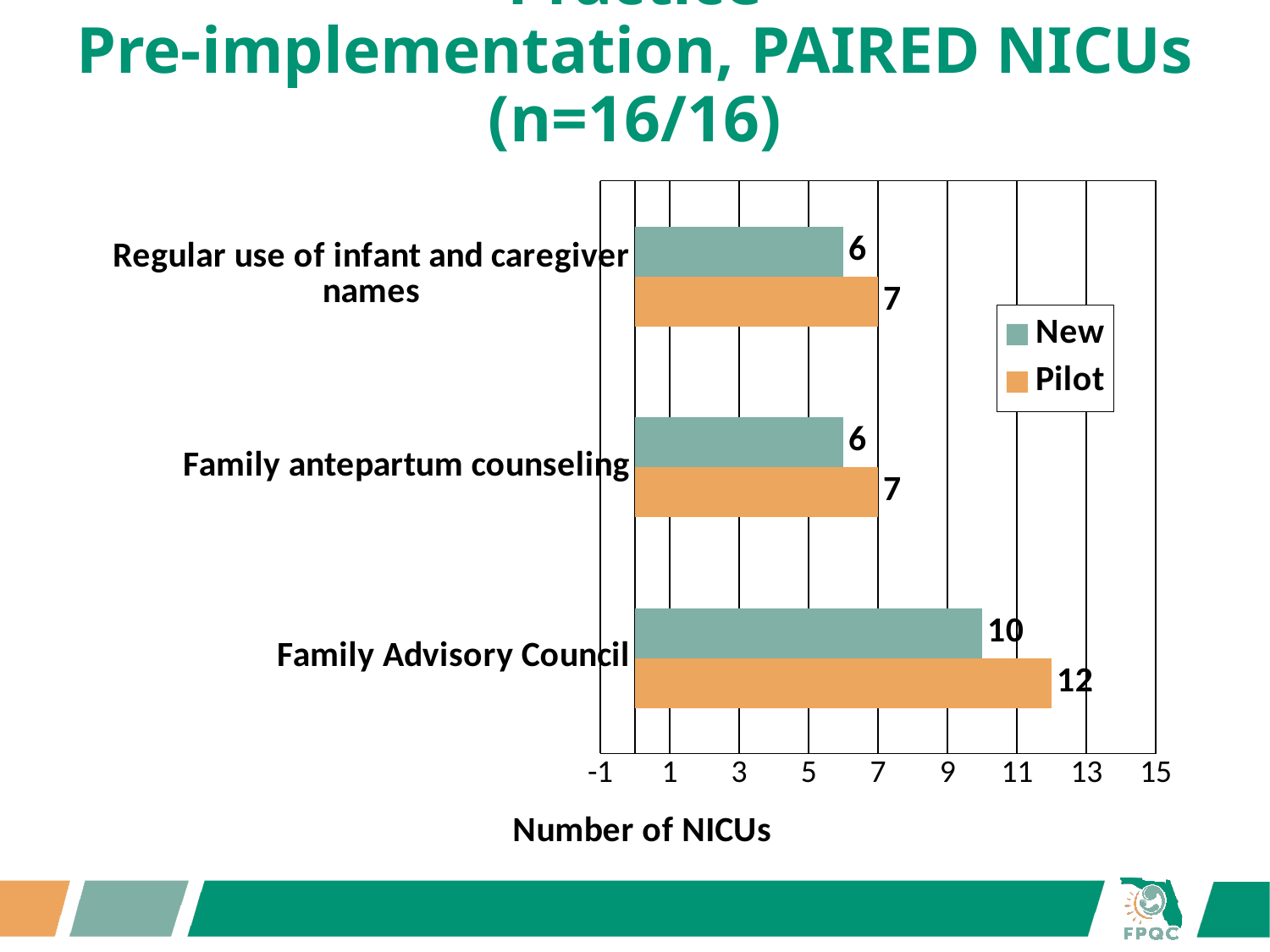
How many series does the legend list? 2 What is the New value for Family Advisory Council? 10 What is the Pilot value for Family Advisory Council? 12 What is the New value for Family antepartum counseling? 6 What is the difference between the Pilot and New values for Family Advisory Council? 2 Is the New value for Family Advisory Council greater or less than 9? greater What kind of chart is shown on the slide? bar chart Which category has the highest Pilot value? Family Advisory Council Which is larger for Family antepartum counseling, the New value or the Pilot value? Pilot How many categories are shown on the chart? 3 What is the label of the horizontal axis? Number of NICUs What is the Pilot value for Regular use of infant and caregiver names? 7